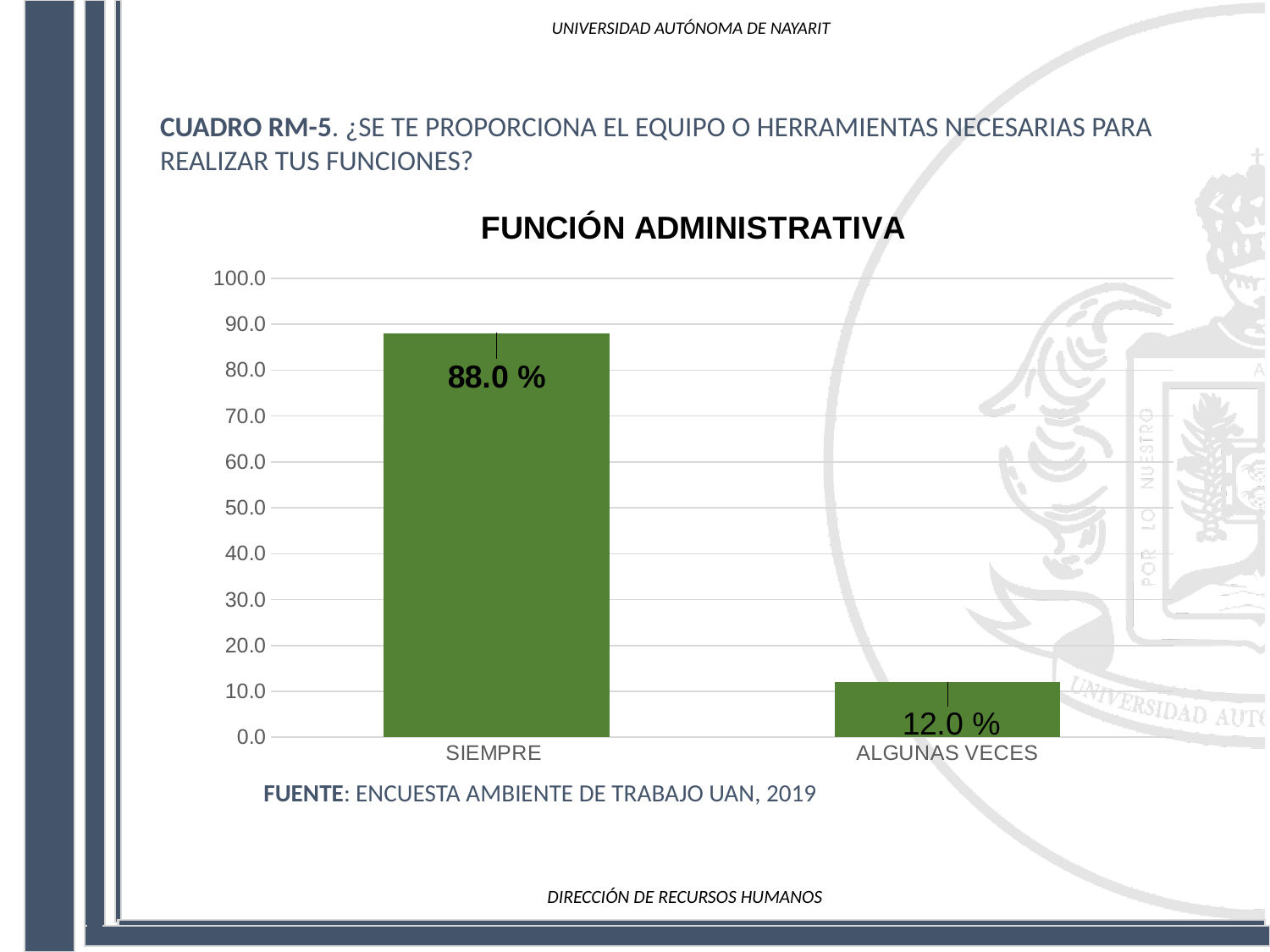
What is the difference between the values for SIEMPRE and ALGUNAS VECES? 76.0 % What is the highest value shown on the y axis? 100.0 Which category has the highest value? SIEMPRE How many categories are shown on the x axis? 2 What is the title of the chart? FUNCIÓN ADMINISTRATIVA What kind of chart is shown on the slide? bar chart What is the value for ALGUNAS VECES? 12.0 % Which category has the lowest value? ALGUNAS VECES Is the value for ALGUNAS VECES greater or less than 20.0? less Is the value for SIEMPRE greater or less than 80.0? greater What is the value for SIEMPRE? 88.0 % Which is larger, the value for SIEMPRE or the value for ALGUNAS VECES? SIEMPRE